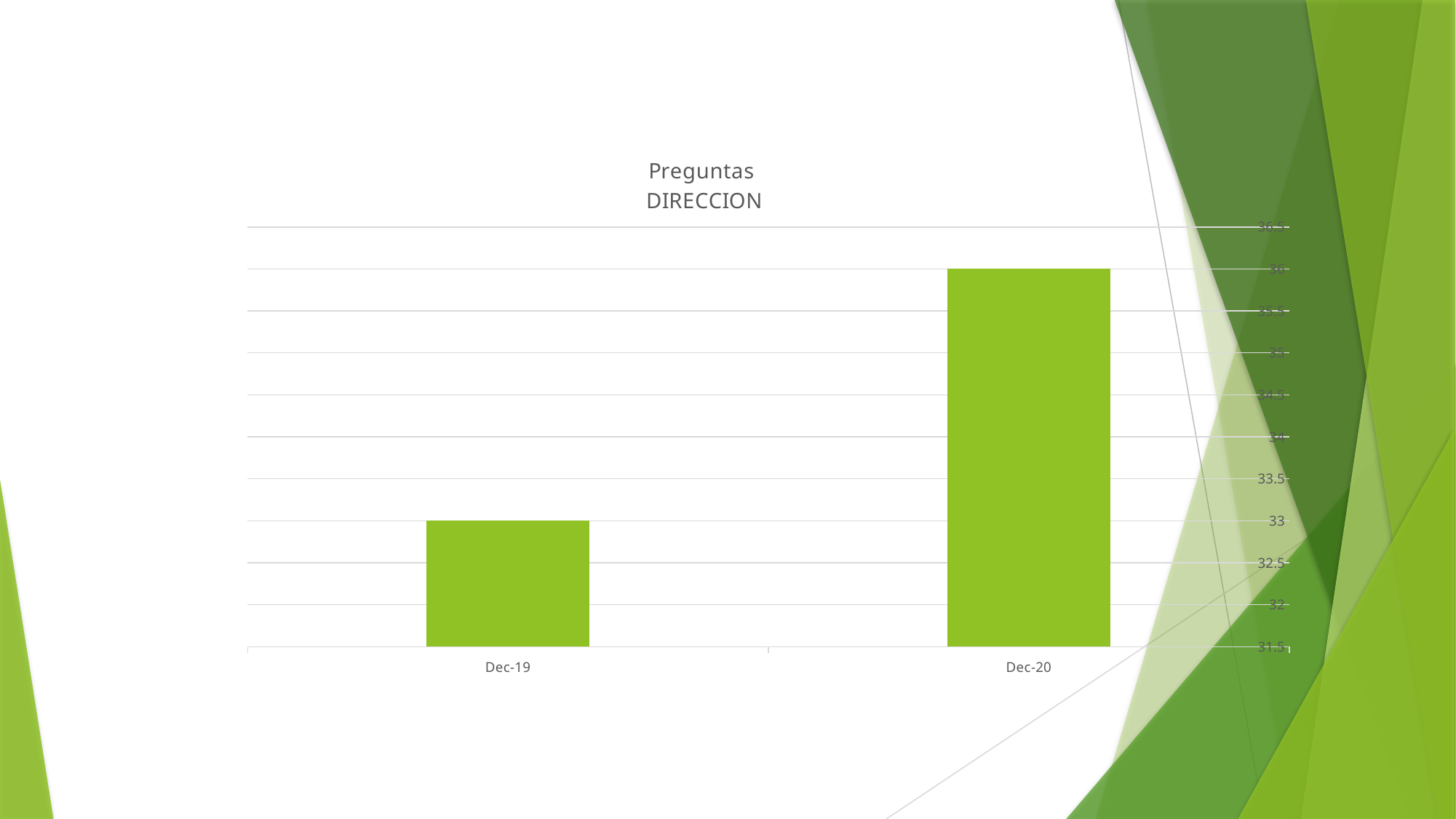
What is the value for Dec-20? 36 What is the title of the chart? Preguntas DIRECCION How many categories are shown on the x axis? 2 What is the difference between the values for Dec-20 and Dec-19? 3 What is the value for Dec-19? 33 Is the value for Dec-20 greater or less than 35? greater Is the value for Dec-19 greater or less than 34? less Which category has the highest value? Dec-20 What kind of chart is shown on the slide? bar chart Which is larger, the value for Dec-19 or the value for Dec-20? Dec-20 Do the values rise or fall from Dec-19 to Dec-20? rise Which category has the lowest value? Dec-19